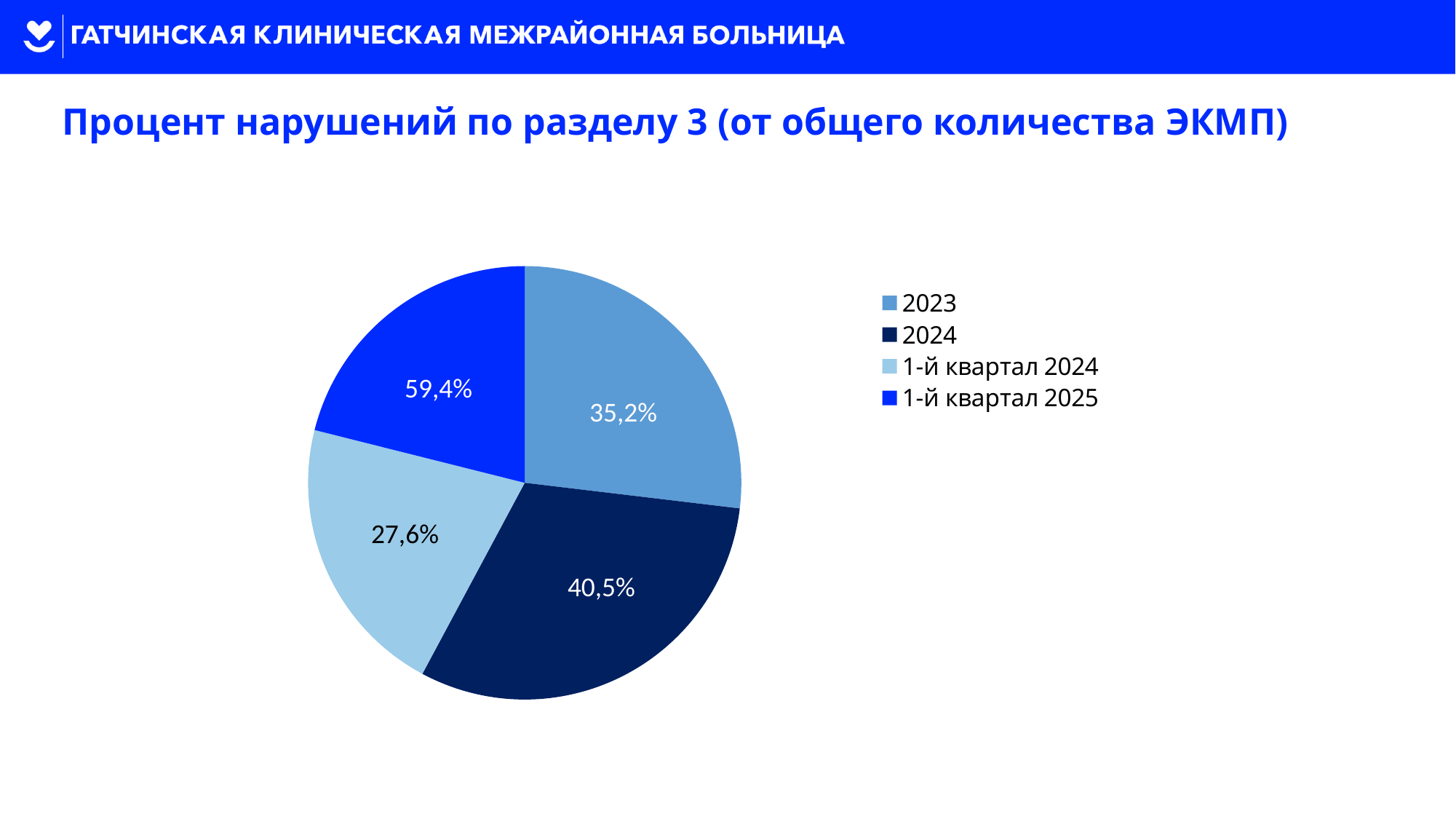
Which category has the lowest value in the pie chart? 1-й квартал 2024 What is the value labelled for the 1-й квартал 2024 slice? 27,6% What is the difference between the values for 2024 and 2023? 5,3% What is the value labelled for the 1-й квартал 2025 slice? 59,4% Which has the larger value, 2023 or 2024? 2024 What is the value labelled for the 2024 slice? 40,5% What is the title of the chart on the slide? Процент нарушений по разделу 3 (от общего количества ЭКМП) How many slices does the pie chart have? 4 What kind of chart is shown on the slide? pie chart What is the value labelled for the 2023 slice? 35,2%